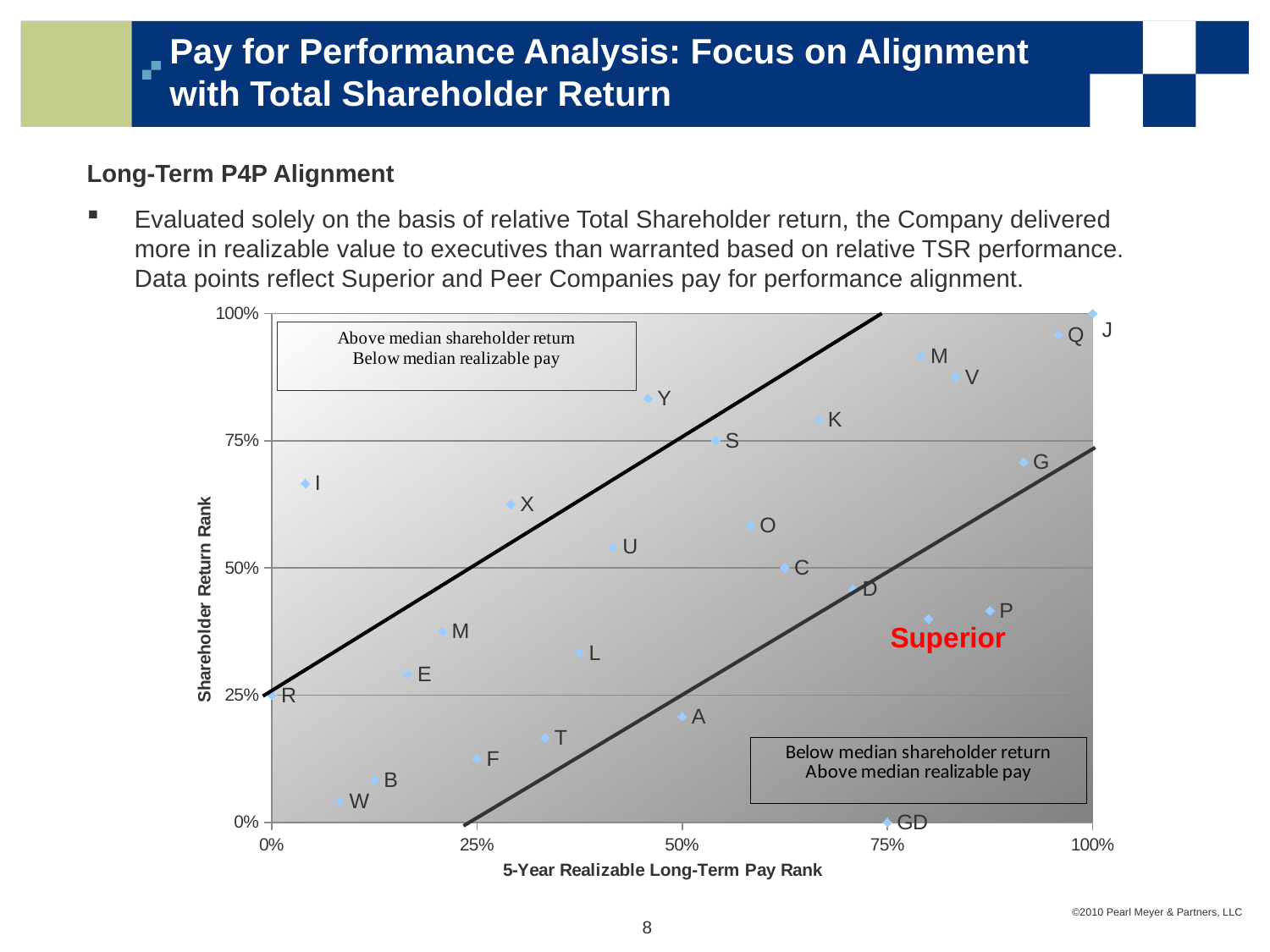
What is the title of the y axis of the chart? Shareholder Return Rank Is the Shareholder Return Rank for the point labeled Superior greater or less than 50%? less Is the Shareholder Return Rank for point Y greater or less than 75%? greater What kind of chart is shown on the slide? scatter chart What is the Shareholder Return Rank of point R? 25% What is the 5-Year Realizable Long-Term Pay Rank of point GD? 75% Which point has a higher Shareholder Return Rank, J or W? J Which labeled point has the lowest Shareholder Return Rank? GD Is the 5-Year Realizable Long-Term Pay Rank for point I greater or less than 25%? less Which point has a higher 5-Year Realizable Long-Term Pay Rank, Q or I? Q What is the title of the x axis of the chart? 5-Year Realizable Long-Term Pay Rank Which labeled point has the highest Shareholder Return Rank? J